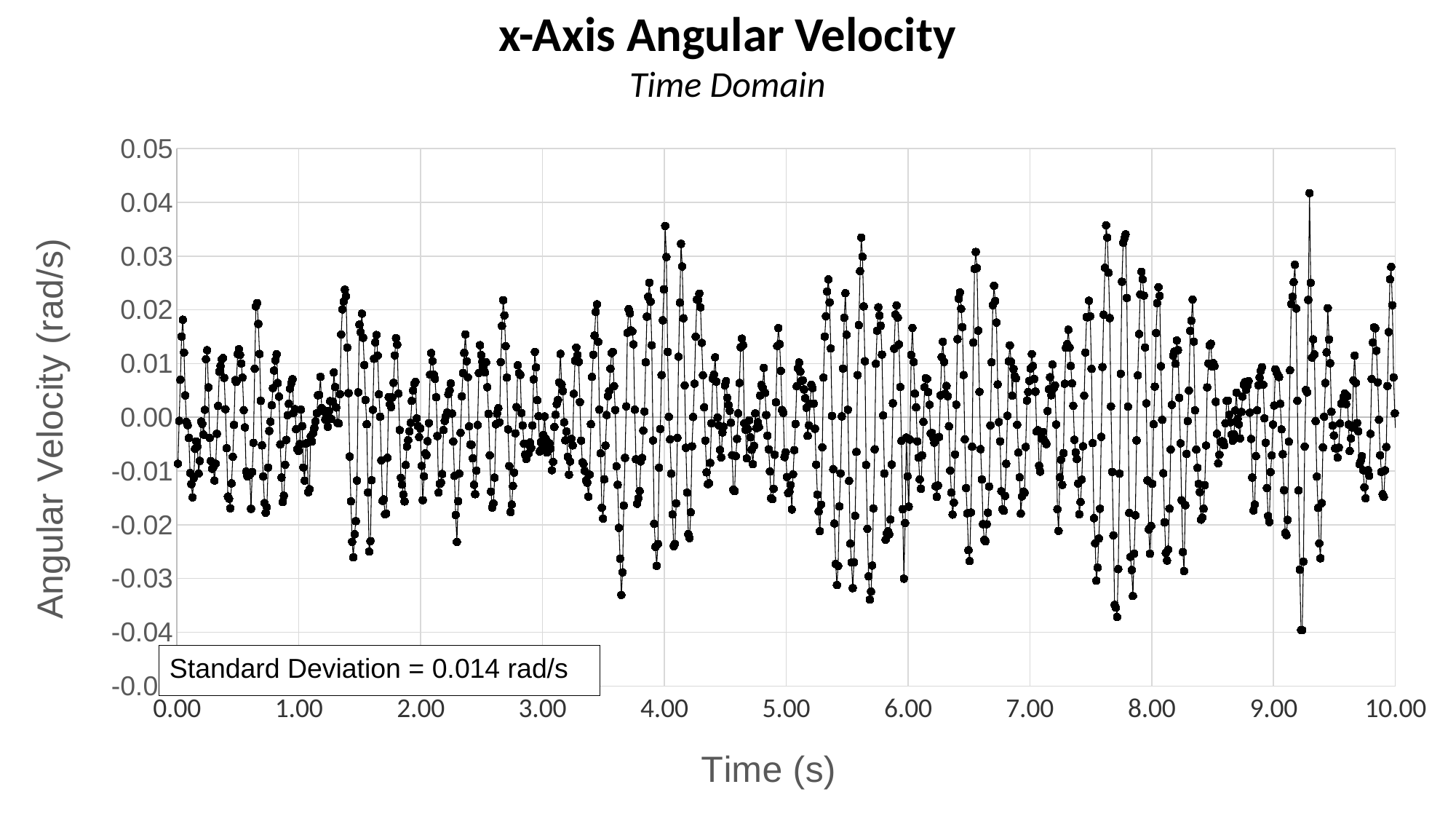
Is the highest angular velocity value plotted near 4.00 s greater or less than 0.03 rad/s? greater What is the maximum value shown on the x axis (Time)? 10.00 What standard deviation value is stated in the text box on the chart? 0.014 rad/s Which is larger: the peak angular velocity near 9.30 s or the peak near 1.35 s? The peak near 9.30 s Which is larger: the peak angular velocity near 4.00 s or the peak near 0.65 s? The peak near 4.00 s What kind of chart is shown on the slide? Line chart with markers (scatter) Is the highest angular velocity value plotted near 9.30 s greater or less than 0.03 rad/s? greater Is the highest angular velocity value plotted between 2.00 s and 3.00 s greater or less than 0.03 rad/s? less What is the title of the chart? x-Axis Angular Velocity